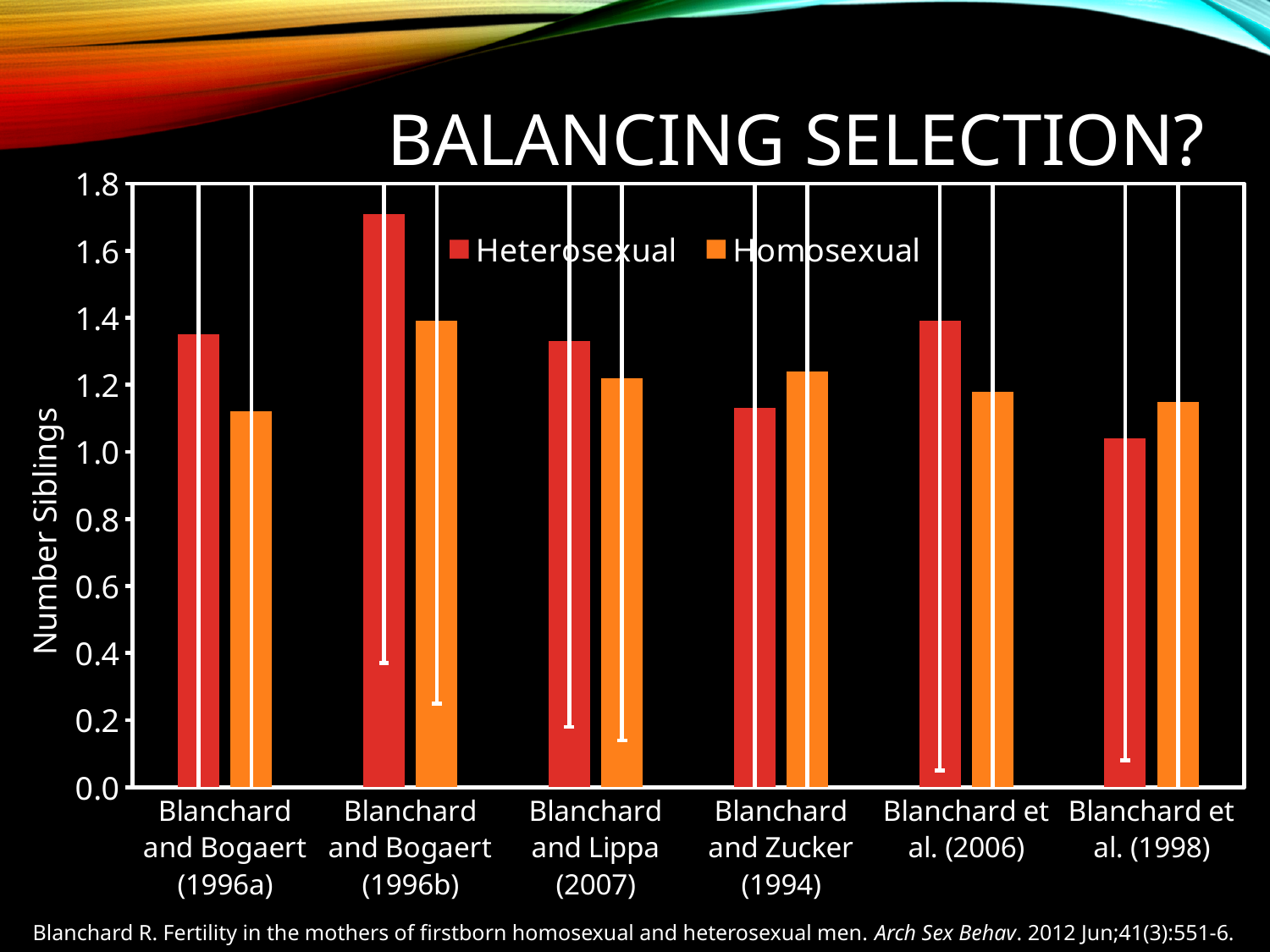
Which study has the highest Homosexual value? Blanchard and Bogaert (1996b) Is the Homosexual value for Blanchard and Bogaert (1996a) greater or less than 1.2? less For Blanchard and Zucker (1994), which is larger, the Heterosexual or the Homosexual value? Homosexual Is the Heterosexual value for Blanchard and Bogaert (1996b) greater or less than 1.6? greater Is the Heterosexual value for Blanchard et al. (1998) greater or less than 1.2? less How many series does the legend list? 2 How many studies (categories) are shown along the x axis? 6 For Blanchard et al. (2006), which is larger, the Heterosexual or the Homosexual value? Heterosexual What kind of chart is shown on the slide? bar chart Which study has the lowest Heterosexual value? Blanchard et al. (1998) Which study has the highest Heterosexual value? Blanchard and Bogaert (1996b) What is the label of the vertical axis? Number Siblings